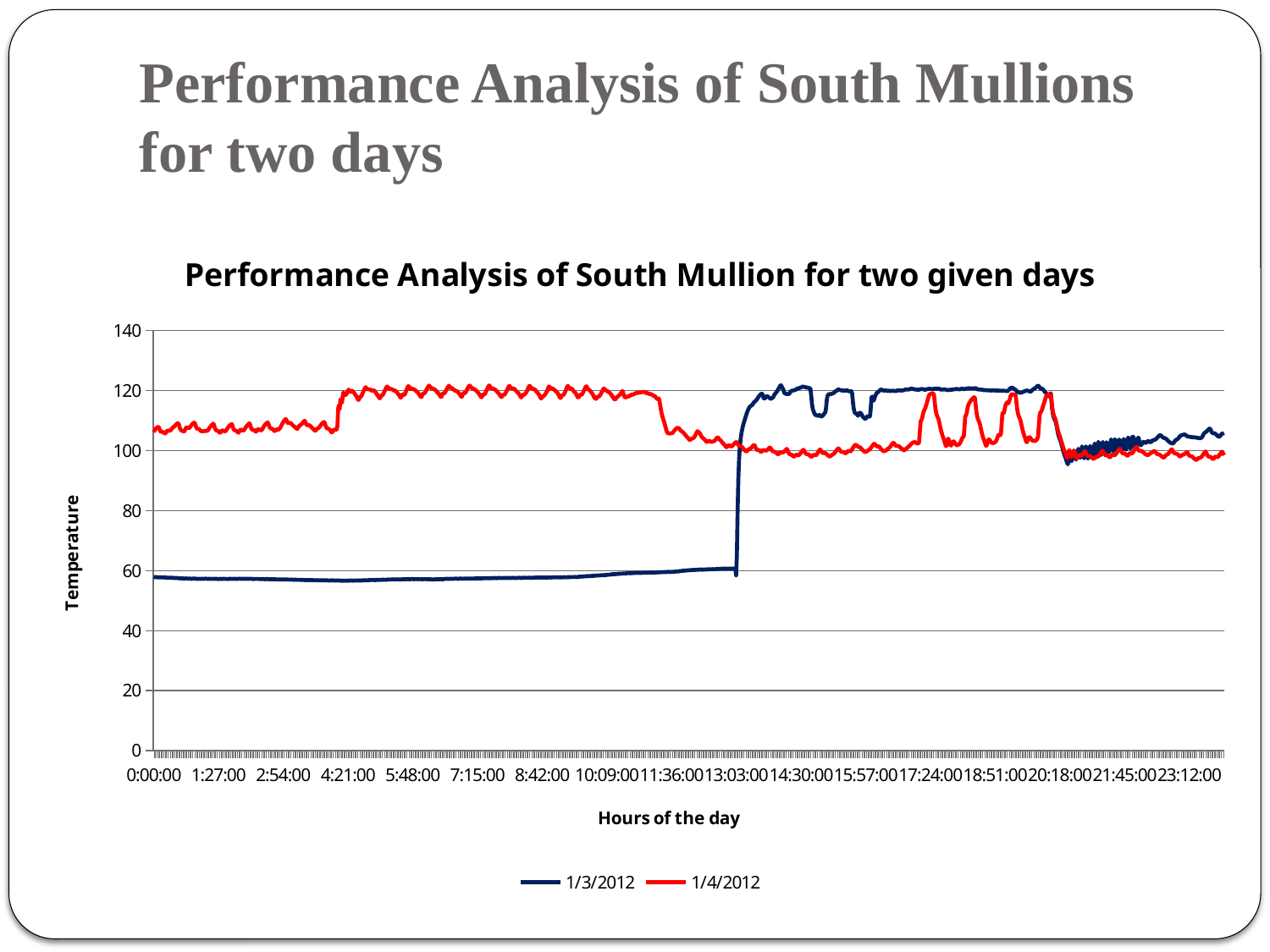
Is the value for 1/4/2012 at 0:00:00 greater or less than 100? greater Does the 1/4/2012 line rise or fall between 10:09:00 and 11:36:00? fall Is the value for 1/4/2012 at 5:48:00 greater or less than 100? greater What are the two series named in the chart legend? 1/3/2012 and 1/4/2012 How many series does the chart legend list? 2 At 14:30:00, which series has the higher temperature, 1/3/2012 or 1/4/2012? 1/3/2012 Does the 1/3/2012 line rise or fall sharply around 13:03:00? rise At 5:48:00, which series has the higher temperature, 1/3/2012 or 1/4/2012? 1/4/2012 What is the title of the chart's vertical axis? Temperature Is the value for 1/3/2012 at 0:00:00 greater or less than 80? less What kind of chart is shown on the slide? line chart